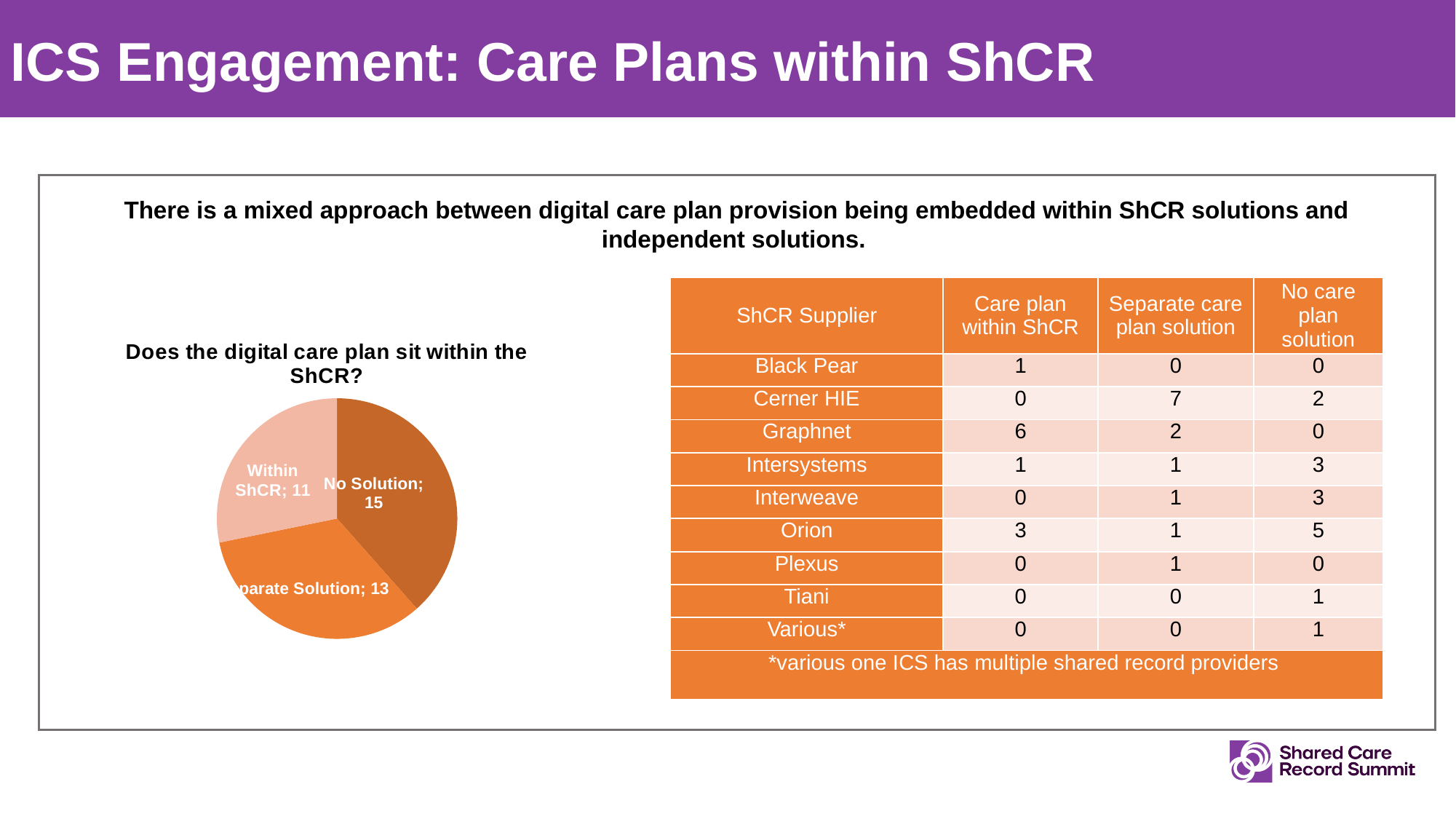
What is the value for the 'Separate Solution' slice in the pie chart? 13 What is the difference between the 'No Solution' and 'Within ShCR' values in the pie chart? 4 What is the value for the 'Within ShCR' slice in the pie chart? 11 What is the total of all slices in the pie chart? 39 What is the value for the 'No Solution' slice in the pie chart? 15 Which is larger in the pie chart, 'Separate Solution' or 'Within ShCR'? Separate Solution What is the title of the pie chart? Does the digital care plan sit within the ShCR? What kind of chart is shown on the slide? pie chart Which slice of the pie chart is the smallest? Within ShCR Which slice of the pie chart is the largest? No Solution How many slices does the pie chart have? 3